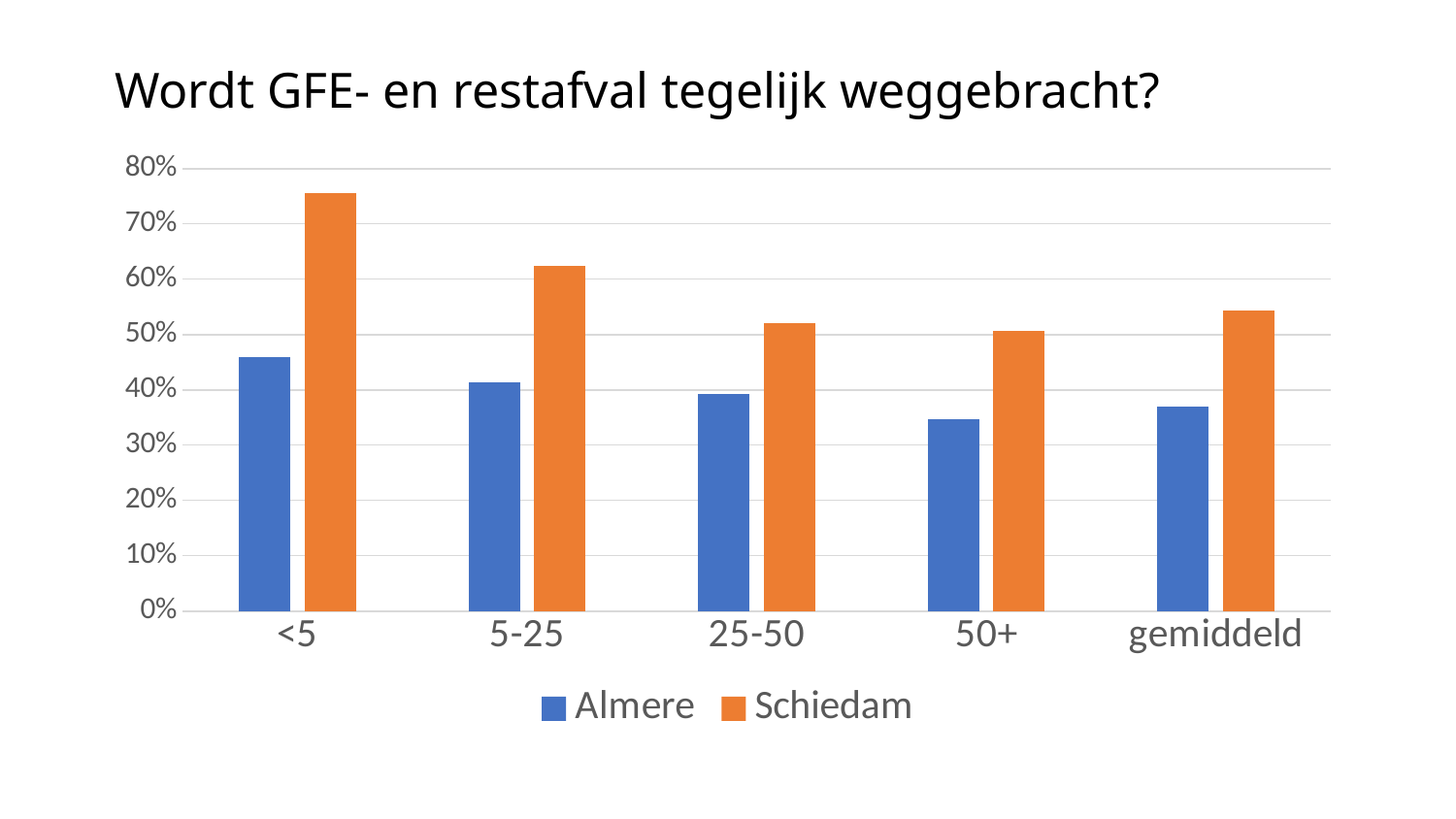
Is the value for Schiedam in the 5-25 category greater or less than 60%? greater Is the value for Almere in the <5 category greater or less than 50%? less What is the title of the chart? Wordt GFE- en restafval tegelijk weggebracht? In the <5 category, which is larger: Almere or Schiedam? Schiedam What kind of chart is shown on the slide? bar chart For which category is the Schiedam value highest? <5 Is the value for Schiedam in the <5 category greater or less than 70%? greater Which series is shown in orange? Schiedam For which category is the Almere value lowest? 50+ How many categories are shown on the x axis? 5 How many series does the legend list? 2